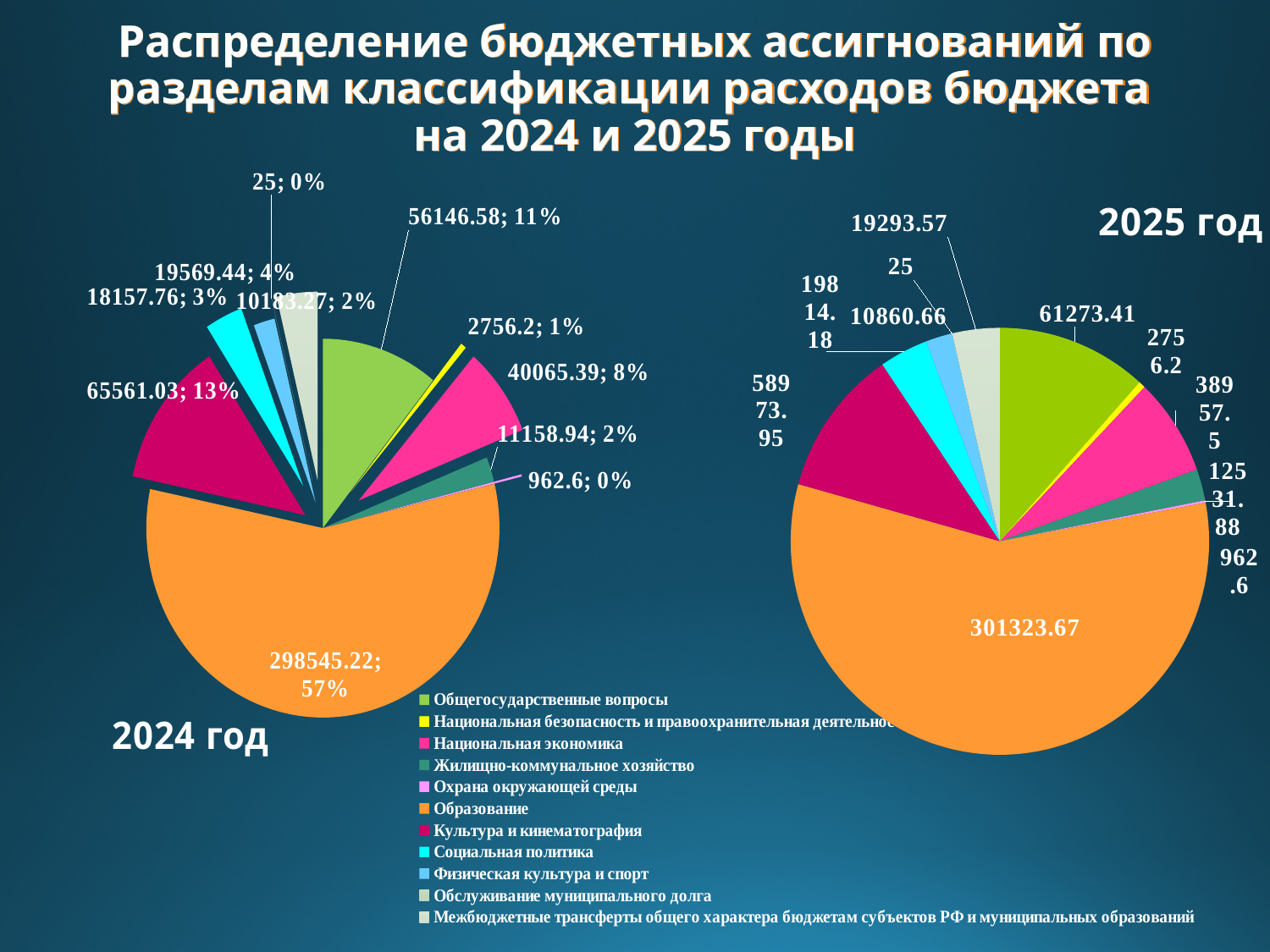
In the 2025 год chart, which is larger: Общегосударственные вопросы or Культура и кинематография? Общегосударственные вопросы In the 2024 год chart, which category has the largest slice? Образование What kind of chart is used on the slide for the 2024 год and 2025 год data? Pie chart In the 2024 год chart, what is the difference between Общегосударственные вопросы and Национальная экономика? 16081.19 In the 2024 год chart, what value is shown for Образование? 298545.22 How many categories does the legend list? 11 In the 2025 год chart, what value is shown for Общегосударственные вопросы? 61273.41 In the 2024 год chart, what value is shown for Культура и кинематография? 65561.03 By how much does the value for Образование in the 2025 год chart exceed the value in the 2024 год chart? 2778.45 In the 2024 год chart, what share of the pie does Культура и кинематография take? 13% In the 2024 год chart, what share of the pie does Образование take? 57% In the 2025 год chart, what value is shown for Образование? 301323.67